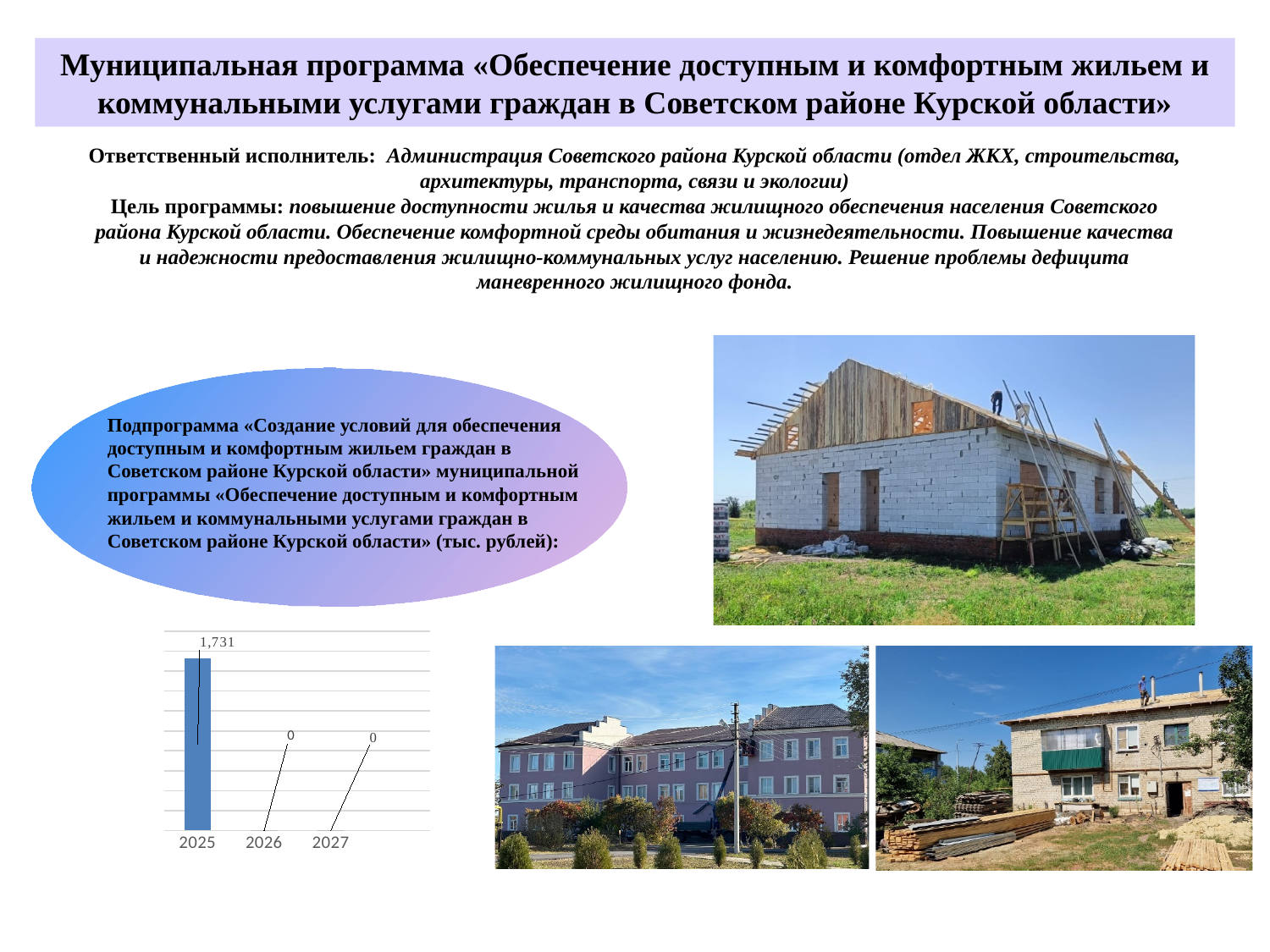
What is the value for 2026 in the bar chart? 0 What is the difference between the values for 2025 and 2026 in the bar chart? 1,731 How many years are shown on the x axis of the bar chart? 3 What is the value for 2027 in the bar chart? 0 What is the total of the values for 2025, 2026 and 2027 in the bar chart? 1,731 Do the values in the bar chart rise or fall from 2025 to 2027? fall What unit of measurement is stated for the subprogramme figures shown in the chart? тыс. рублей What colour is the bar for 2025 in the bar chart? blue Which is larger in the bar chart, the value for 2025 or the value for 2027? 2025 What kind of chart is shown on the slide? bar chart Which year has the highest value in the bar chart? 2025 What is the value for 2025 in the bar chart? 1,731